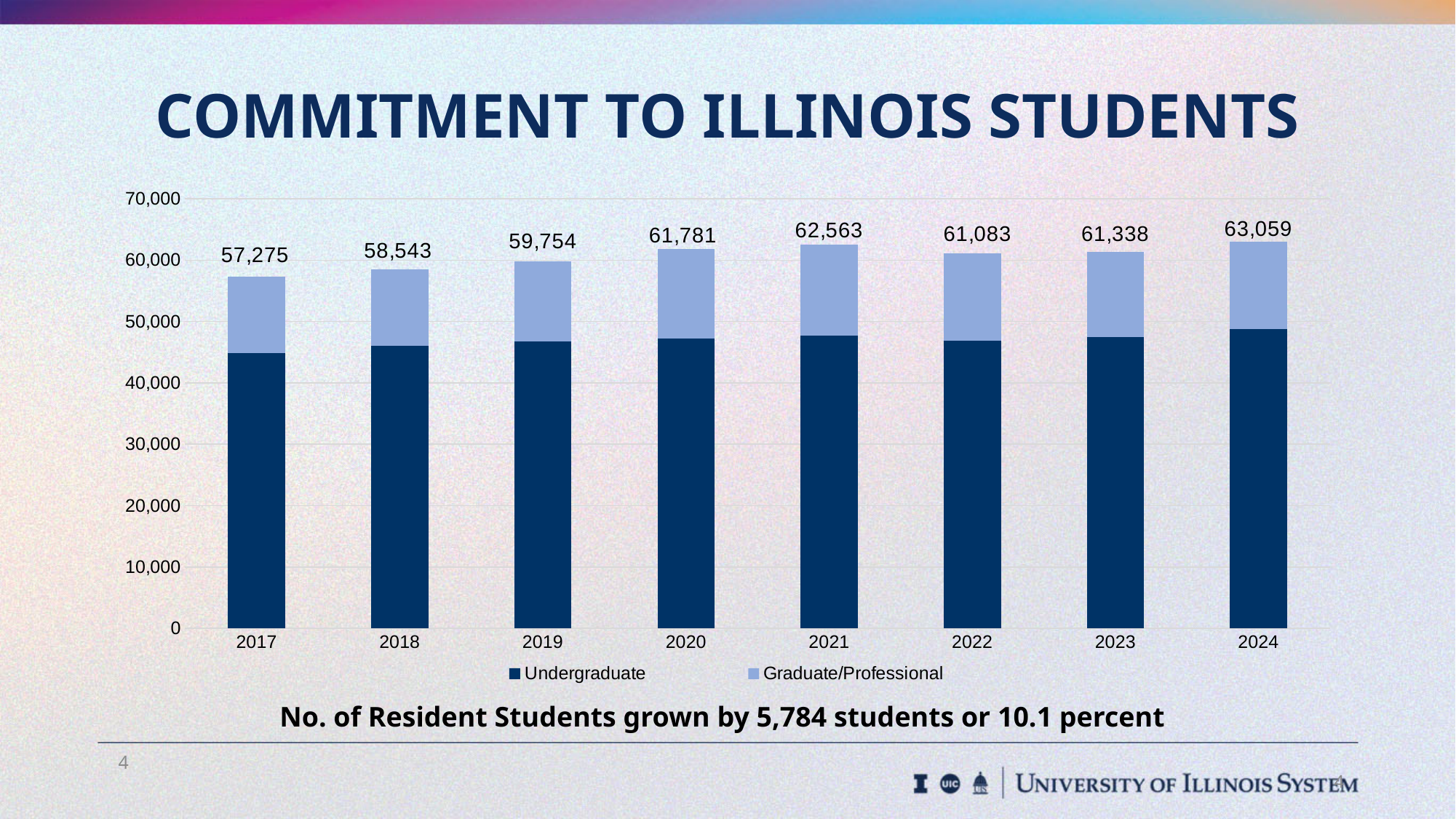
How many series does the legend list? 2 Do the total values rise or fall from 2017 to 2021? rise Is the Undergraduate value for 2017 greater or less than 50,000? less Which year has the lowest total number of resident students? 2017 How many years are shown on the x axis of the chart? 8 What kind of chart is shown on the slide? Stacked bar chart What is the total number of resident students shown for 2024? 63,059 Which year has a larger total, 2022 or 2023? 2023 What is the total number of resident students shown for 2021? 62,563 What is the difference between the total for 2024 and the total for 2017? 5,784 Which year has the highest total number of resident students? 2024 What is the total number of resident students shown for 2017? 57,275